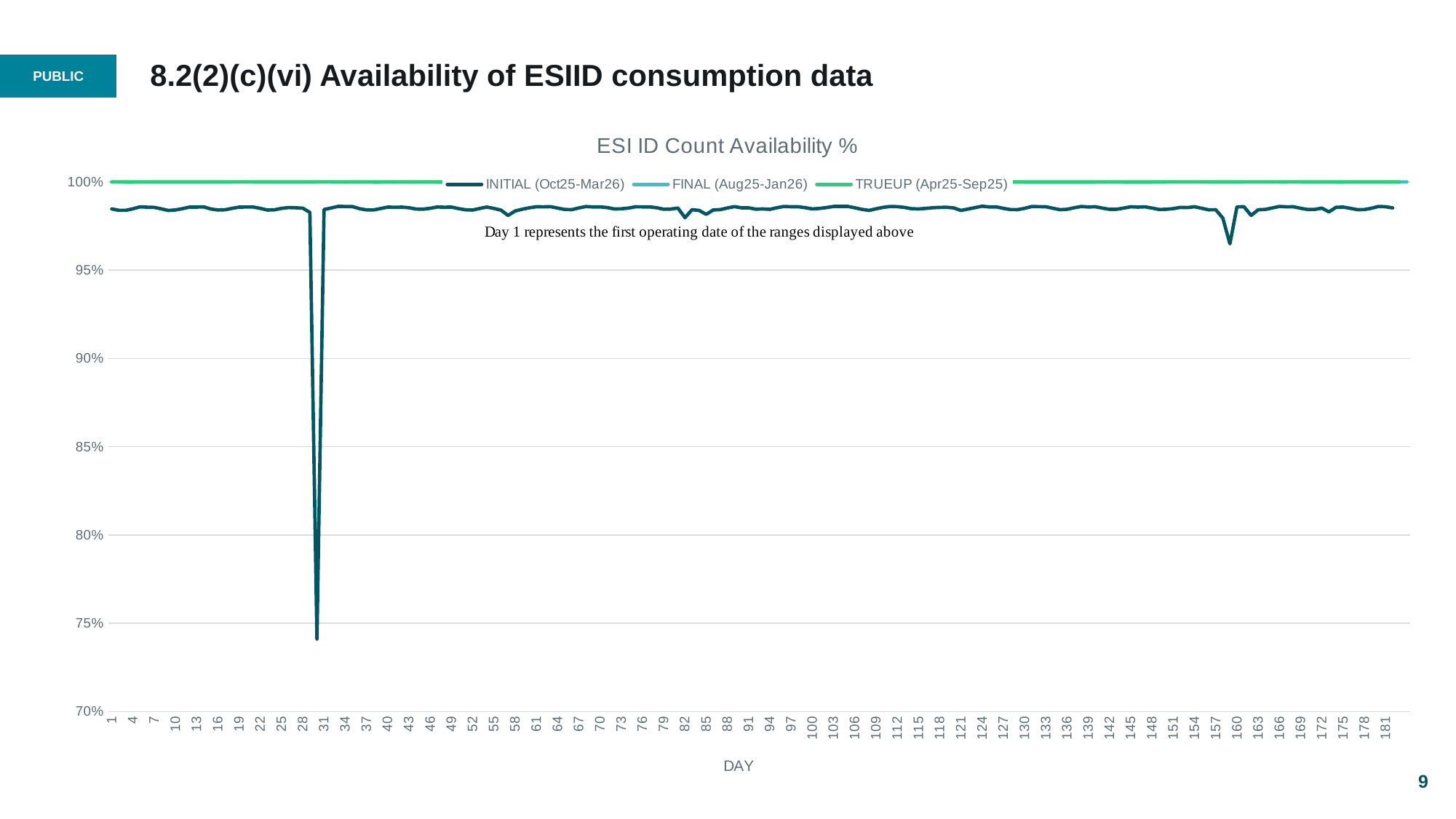
At day 30, which is larger: the INITIAL (Oct25-Mar26) value or the TRUEUP (Apr25-Sep25) value? TRUEUP (Apr25-Sep25) What is the title of the chart? ESI ID Count Availability % Which series reaches the lowest value anywhere on the chart? INITIAL (Oct25-Mar26) What is the label of the x axis? DAY Is the value of the INITIAL (Oct25-Mar26) series at day 30 greater or less than 75%? less What kind of chart is shown on the slide? line chart Is the value of the INITIAL (Oct25-Mar26) series at day 82 greater or less than 95%? greater What is the last day label shown on the x axis? 181 How many series does the legend of the ESI ID Count Availability % chart list? 3 Is the value of the INITIAL (Oct25-Mar26) series at day 160 greater or less than 95%? greater